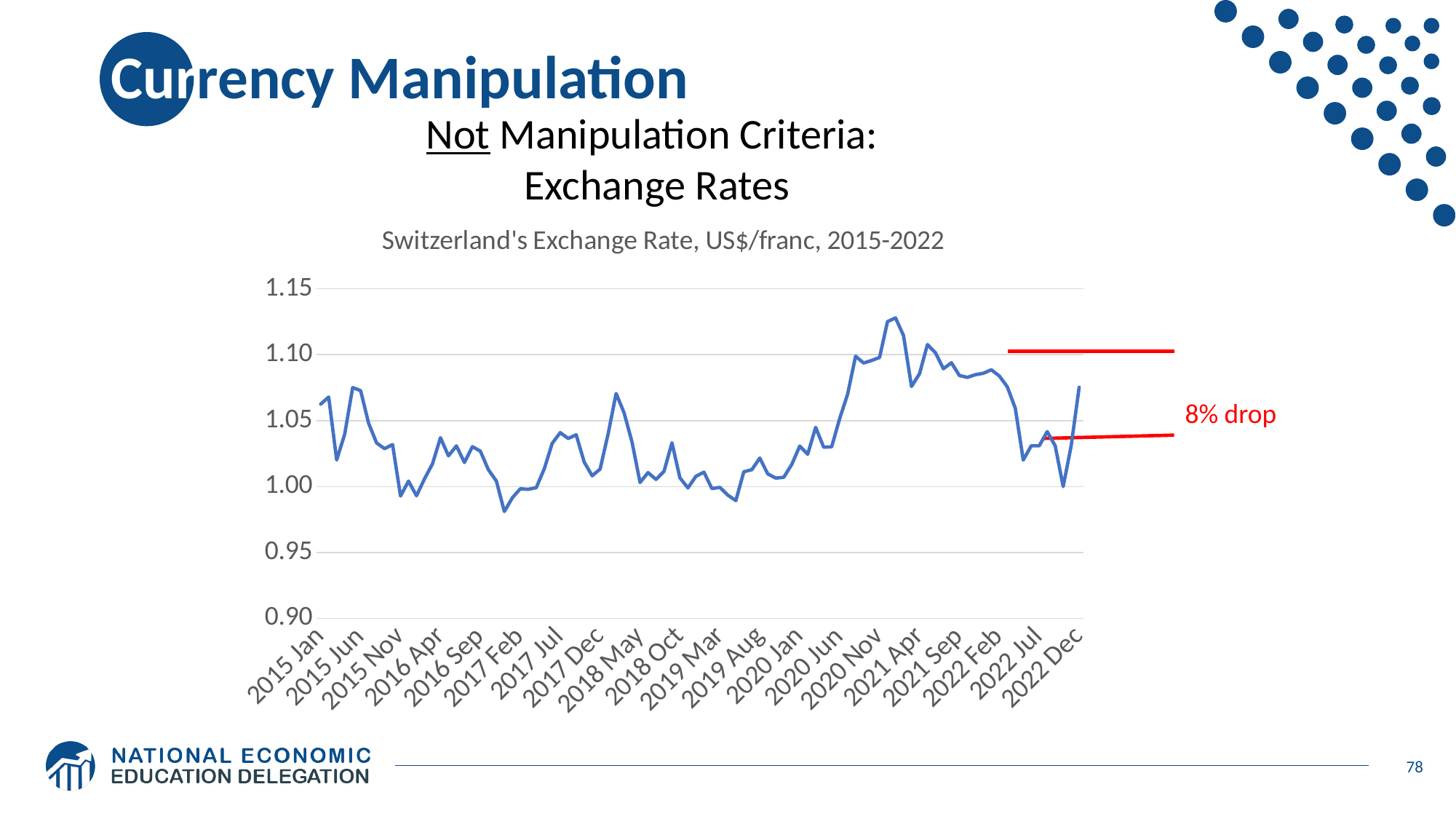
What does the red annotation next to the chart say? 8% drop Is the exchange rate at 2016 Sep greater or less than 1.00? greater What is the title of the chart? Switzerland's Exchange Rate, US$/franc, 2015-2022 Which is higher, the exchange rate at 2015 Jan or at 2017 Feb? 2015 Jan How many month labels are shown on the x axis? 20 Near which labeled month does the line reach its lowest value? 2017 Feb Is the exchange rate at 2022 Dec greater or less than 1.05? greater Is the exchange rate at 2015 Jan greater or less than 1.00? greater What kind of chart is shown on the slide? line chart Does the exchange rate rise or fall between 2020 Jan and 2020 Nov? rise What is the highest value shown on the y axis? 1.15